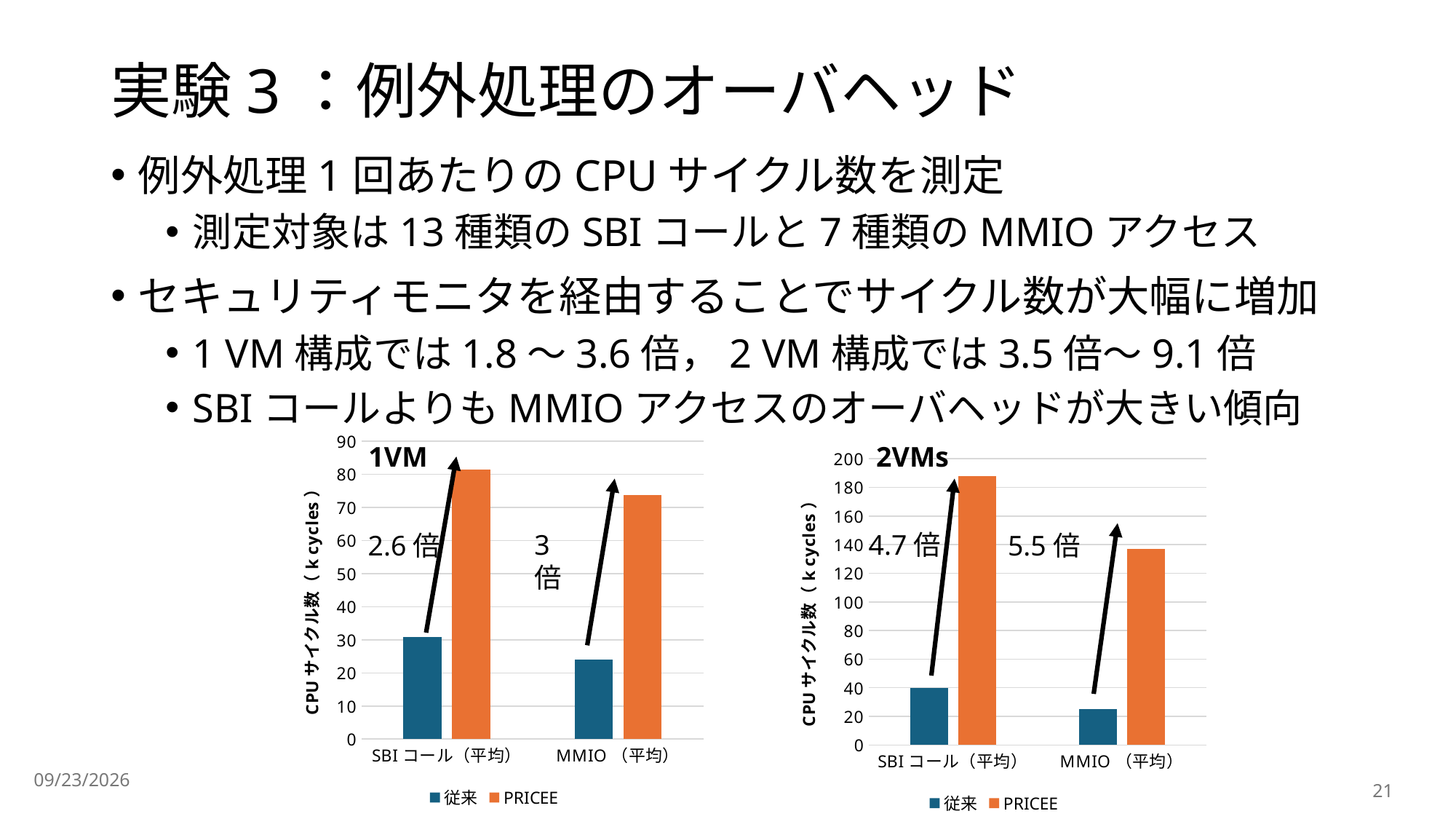
How many categories are shown on the x axis of the 1VM chart? 2 In the 1VM chart, is the 従来 value for SBI コール（平均） greater or less than 40? less In the 2VMs chart, which bar is the lowest? 従来 for MMIO（平均） How many series does the legend of the 2VMs chart list? 2 What kind of chart is the 1VM chart? bar chart In the 2VMs chart, which is larger for MMIO（平均）: 従来 or PRICEE? PRICEE What ratio is annotated above the SBI コール（平均） bars in the 2VMs chart? 4.7 倍 In the 1VM chart, which bar is the highest? PRICEE for SBI コール（平均） In the 2VMs chart, is the PRICEE value for SBI コール（平均） greater or less than 160? greater In the 1VM chart, is the 従来 value for MMIO（平均） greater or less than 30? less